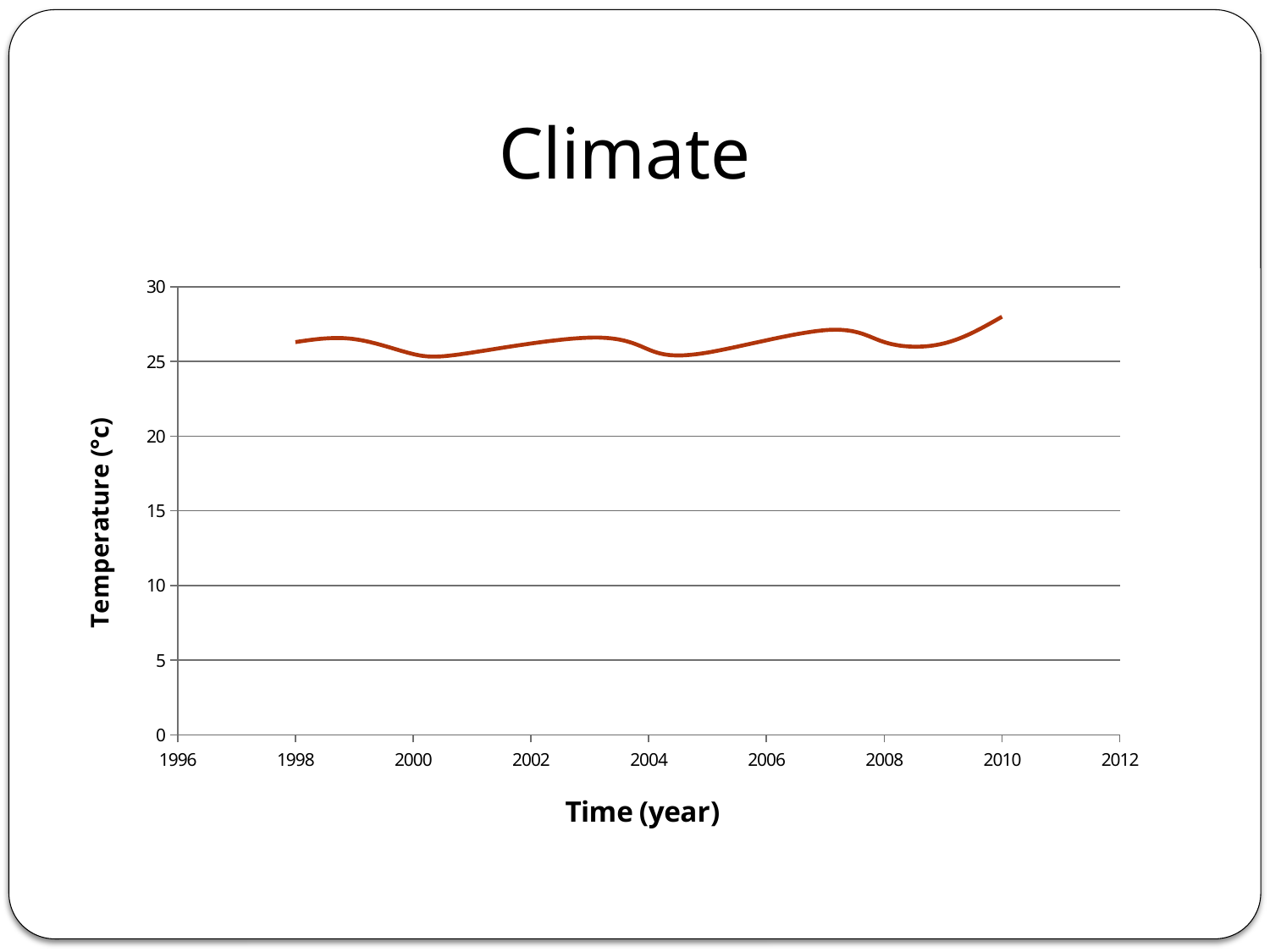
Is the temperature value for 2008 greater or less than 30? less What is the label on the vertical axis of the chart? Temperature (°c) Is the temperature value for 2010 greater or less than 30? less Is the temperature value for 1998 greater or less than 25? greater What is the title of the chart? Climate Which year has the higher temperature, 2007 or 2004? 2007 In which year does the line reach its highest temperature? 2010 Which year has the higher temperature, 2010 or 2000? 2010 What kind of chart is shown on the slide? line chart